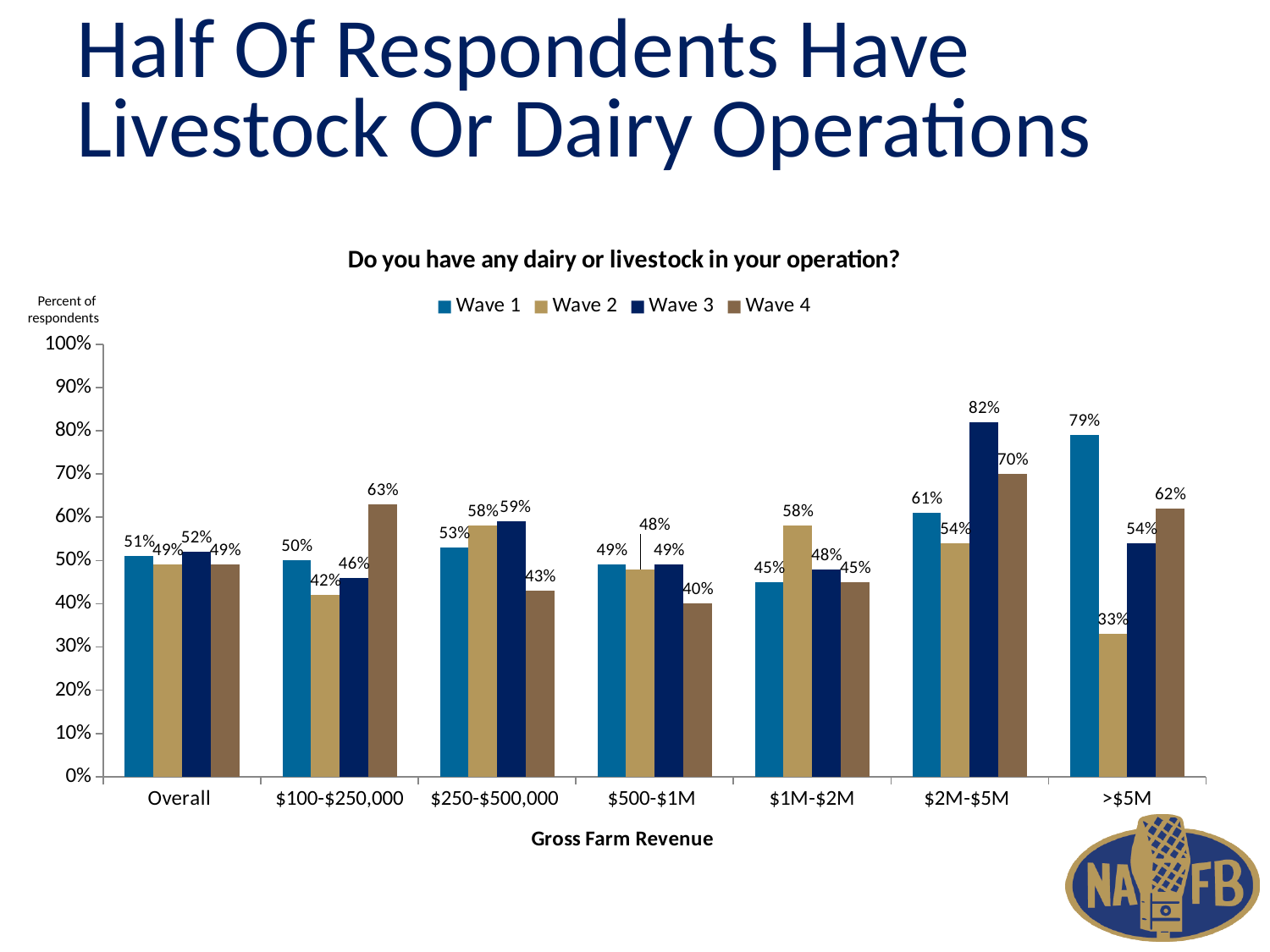
How many gross farm revenue categories are shown on the x axis? 7 How many series does the legend list? 4 Which category has the lowest Wave 2 value? >$5M What is the Wave 3 value for the $2M-$5M category? 82% Which is larger for the $1M-$2M category, the Wave 2 value or the Wave 3 value? Wave 2 What is the difference between the Wave 1 and Wave 2 values for the >$5M category? 46% What is the Wave 2 value for the Overall category? 49% Which category has the highest Wave 3 value? $2M-$5M What is the x-axis title of the chart? Gross Farm Revenue What kind of chart is shown on the slide? Bar chart What is the Wave 1 value for the >$5M category? 79% What is the Wave 4 value for the $100-$250,000 category? 63%